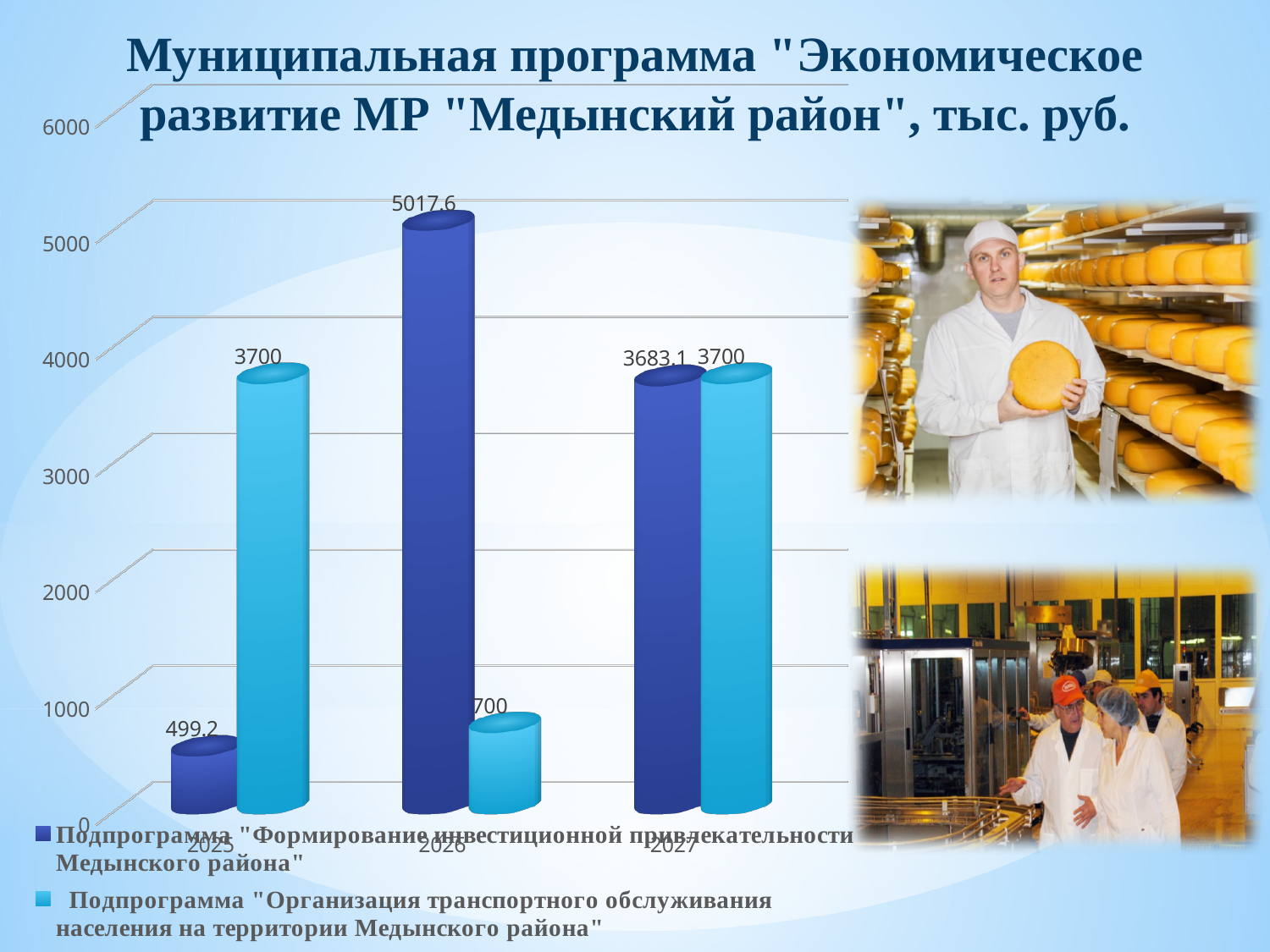
What is the value for the subprogram "Организация транспортного обслуживания населения на территории Медынского района" in 2026? 700 What is the total of the two subprograms' values in 2027? 7383.1 What is the value for the subprogram "Формирование инвестиционной привлекательности Медынского района" in 2026? 5017.6 What is the value for the subprogram "Формирование инвестиционной привлекательности Медынского района" in 2027? 3683.1 What is the difference between the two subprograms' values in 2026? 4317.6 What kind of chart is shown on the slide? Bar chart How many years are shown on the x axis of the chart? 3 In which year is the value for the subprogram "Формирование инвестиционной привлекательности Медынского района" highest? 2026 How many series does the chart legend list? 2 In which year is the value for the subprogram "Организация транспортного обслуживания населения на территории Медынского района" lowest? 2026 What is the value for the subprogram "Формирование инвестиционной привлекательности Медынского района" in 2025? 499.2 Which subprogram has the larger value in 2025? Подпрограмма "Организация транспортного обслуживания населения на территории Медынского района"